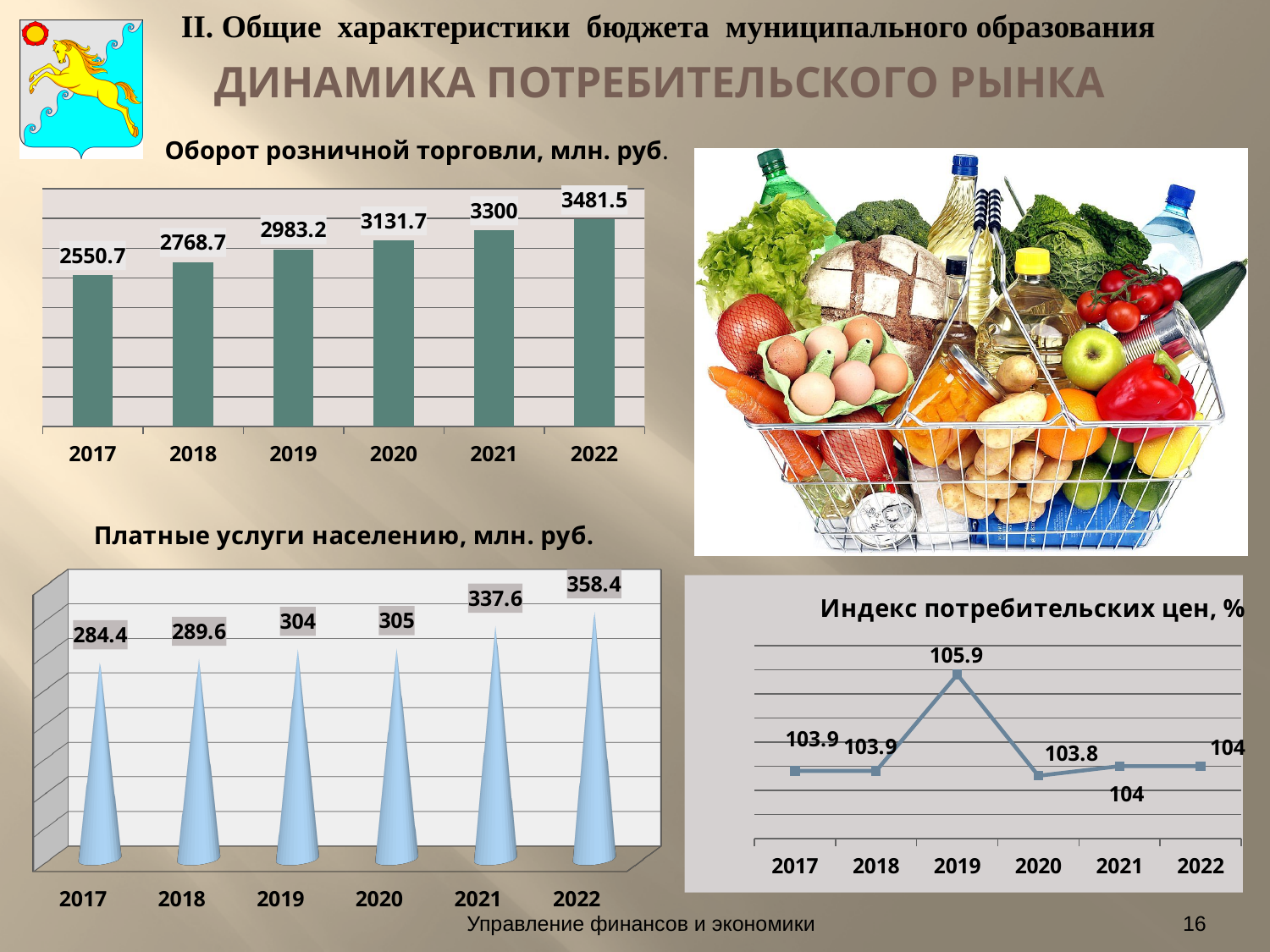
In the chart 'Платные услуги населению, млн. руб.', what is the value for 2021? 337.6 In the chart 'Оборот розничной торговли, млн. руб.', which year has the highest value? 2022 In the chart 'Индекс потребительских цен, %', which is larger, the value for 2019 or the value for 2020? 2019 In the chart 'Платные услуги населению, млн. руб.', which year has the lowest value? 2017 In the chart 'Индекс потребительских цен, %', which year has the lowest value? 2020 In the chart 'Платные услуги населению, млн. руб.', what is the difference between the 2022 and 2021 values? 20.8 In the chart 'Оборот розничной торговли, млн. руб.', what is the value for 2019? 2983.2 In the chart 'Платные услуги населению, млн. руб.', how many years are shown on the x axis? 6 In the chart 'Индекс потребительских цен, %', what is the value for 2019? 105.9 In the chart 'Оборот розничной торговли, млн. руб.', what is the difference between the 2022 and 2017 values? 930.8 In the chart 'Оборот розничной торговли, млн. руб.', do the values rise or fall from 2017 to 2022? rise What kind of chart is 'Индекс потребительских цен, %'? line chart